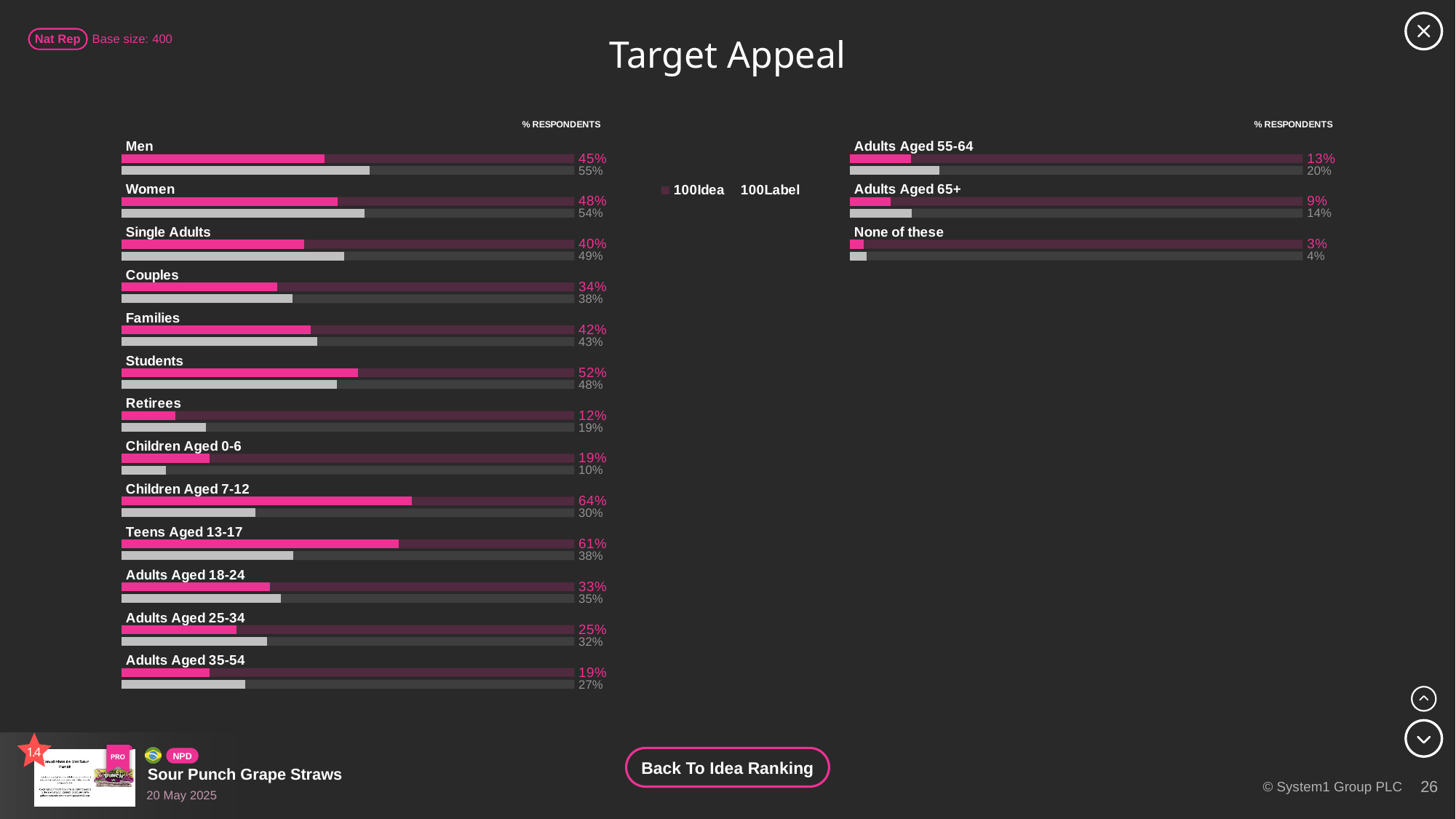
How many categories are shown on the chart? 16 What kind of chart is shown on the slide? Bar chart What is the 100Label value for Children Aged 7-12? 30% Which is larger for Students, the 100Idea value or the 100Label value? 100Idea What is the difference between the 100Idea and 100Label values for Teens Aged 13-17? 23% Which category has the highest 100Idea value? Children Aged 7-12 What are the two series named in the legend? 100Idea and 100Label How many series does the legend list? 2 What is the title of the chart? Target Appeal Which category has the lowest 100Label value? None of these What is the 100Idea value for Men? 45% What is the 100Idea value for Adults Aged 65+? 9%